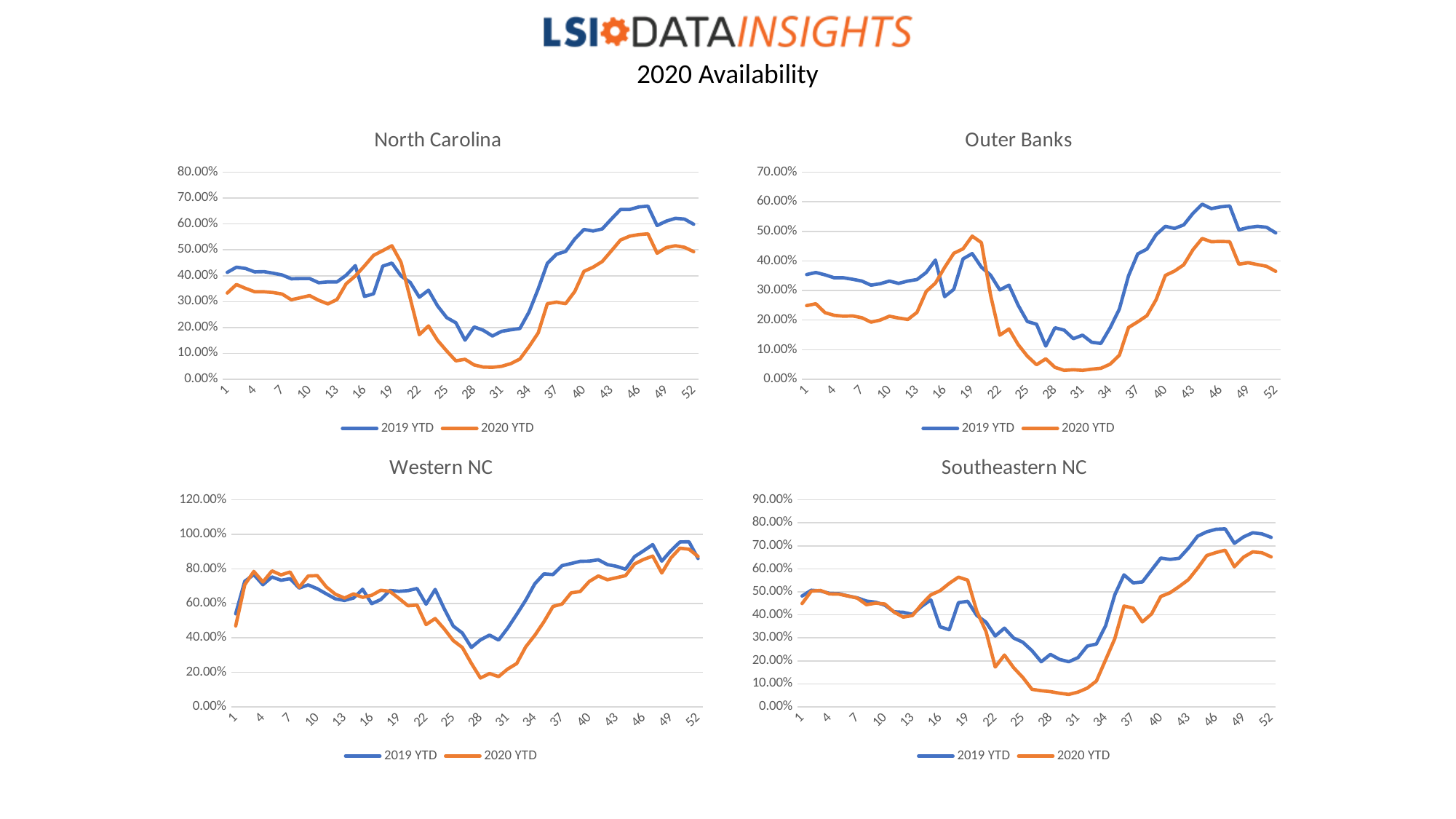
How many series does the legend of the Outer Banks chart list? 2 On the Western NC chart, which series has the larger value at week 28, 2019 YTD or 2020 YTD? 2019 YTD How many charts are shown on the slide? 4 What kind of chart is the North Carolina chart? line chart On the Southeastern NC chart, which series has the larger value at week 19, 2019 YTD or 2020 YTD? 2020 YTD On the Southeastern NC chart, is the 2020 YTD value at week 31 greater or less than 10.00%? less On the North Carolina chart, does the 2019 YTD line rise or fall between week 34 and week 46? rise On the Outer Banks chart, is the 2019 YTD value at week 46 greater or less than 50.00%? greater On the Western NC chart, is the 2019 YTD value at week 46 greater or less than 80.00%? greater What are the legend entries on the Western NC chart? 2019 YTD and 2020 YTD What is the highest value shown on the y axis of the Western NC chart? 120.00%